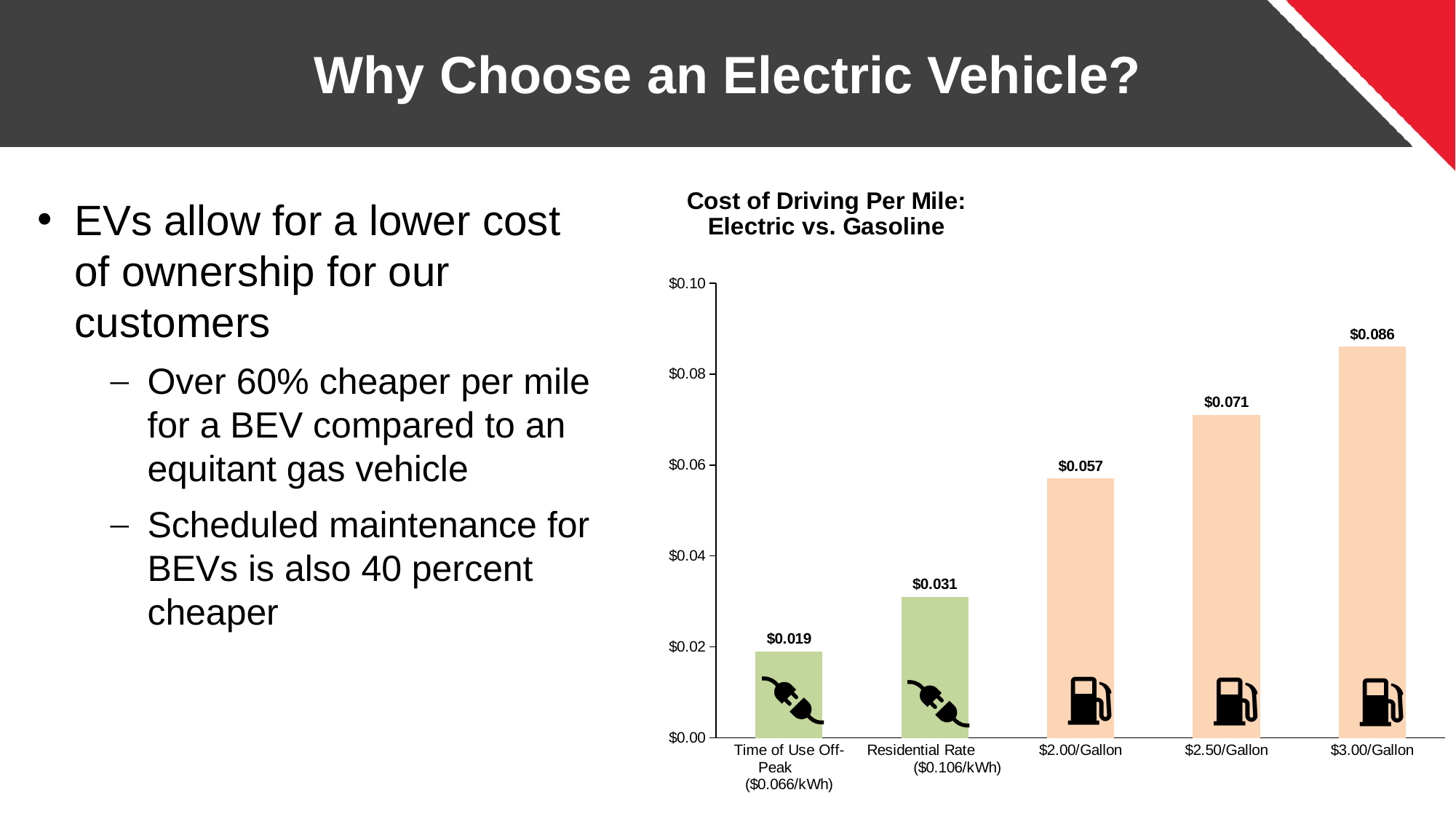
What is the title of the chart? Cost of Driving Per Mile: Electric vs. Gasoline What kind of chart is shown on the slide? bar chart What is the cost of driving per mile at $3.00/Gallon? $0.086 What is the cost of driving per mile at the Residential Rate ($0.106/kWh)? $0.031 Which category has the lowest cost of driving per mile? Time of Use Off-Peak ($0.066/kWh) What is the difference in cost per mile between $3.00/Gallon and Time of Use Off-Peak? $0.067 Which has a higher cost per mile, Residential Rate or $2.00/Gallon? $2.00/Gallon Which category has the highest cost of driving per mile? $3.00/Gallon What is the difference in cost per mile between $2.50/Gallon and $2.00/Gallon? $0.014 Is the cost per mile at $2.50/Gallon greater or less than $0.08? less How many categories are shown on the x axis of the chart? 5 What is the cost of driving per mile for Time of Use Off-Peak ($0.066/kWh)? $0.019